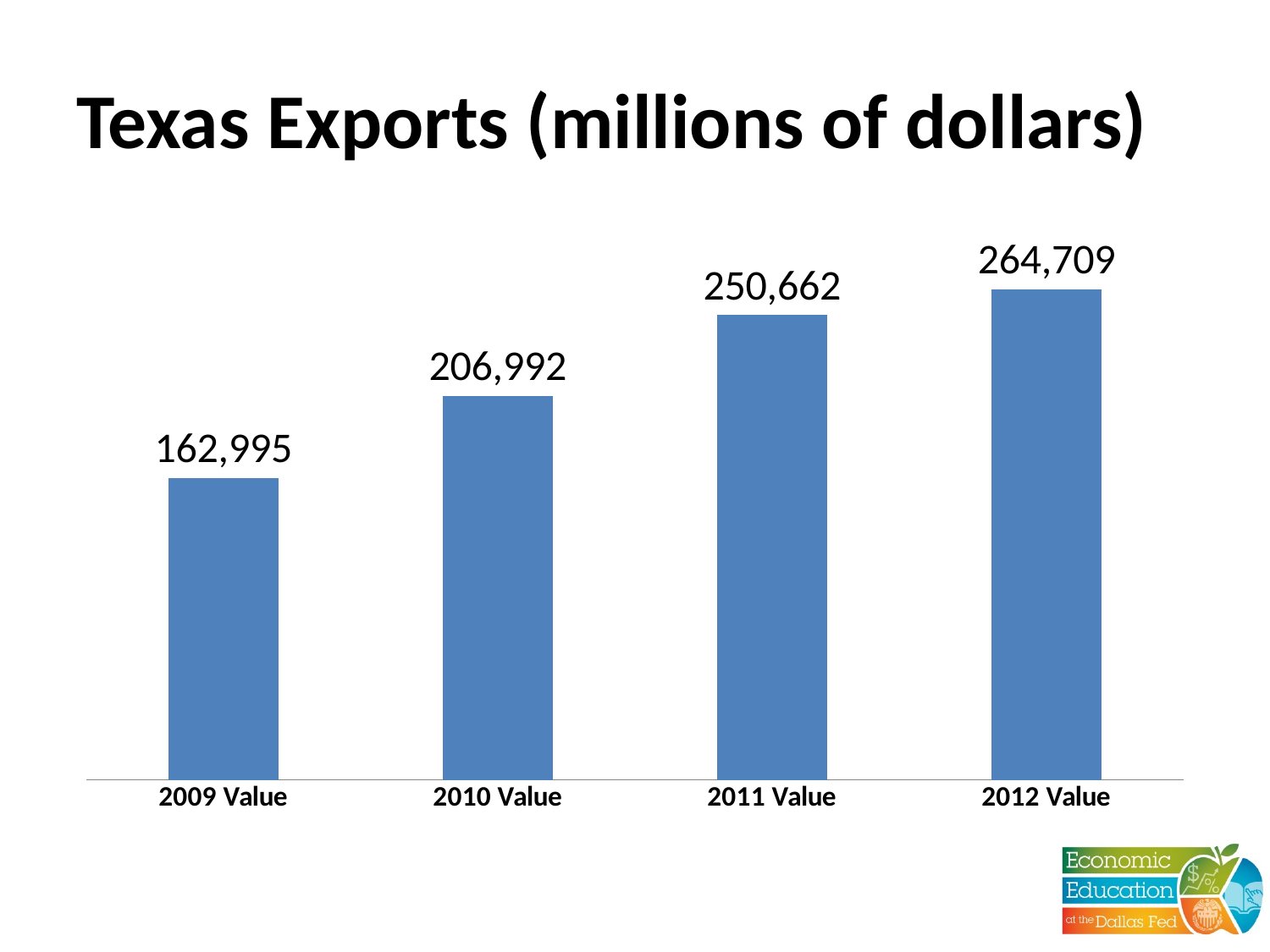
Do the values rise or fall from 2009 Value to 2012 Value? rise What is the value for 2009 Value? 162,995 What kind of chart is this? bar chart Which category has the lowest value? 2009 Value How many categories are shown in the chart? 4 What is the value for 2012 Value? 264,709 What is the difference between the 2012 Value and the 2009 Value? 101,714 What is the difference between the 2011 Value and the 2010 Value? 43,670 Which is larger, the 2010 Value or the 2011 Value? 2011 Value What is the value for 2011 Value? 250,662 What is the value for 2010 Value? 206,992 Which category has the highest value? 2012 Value